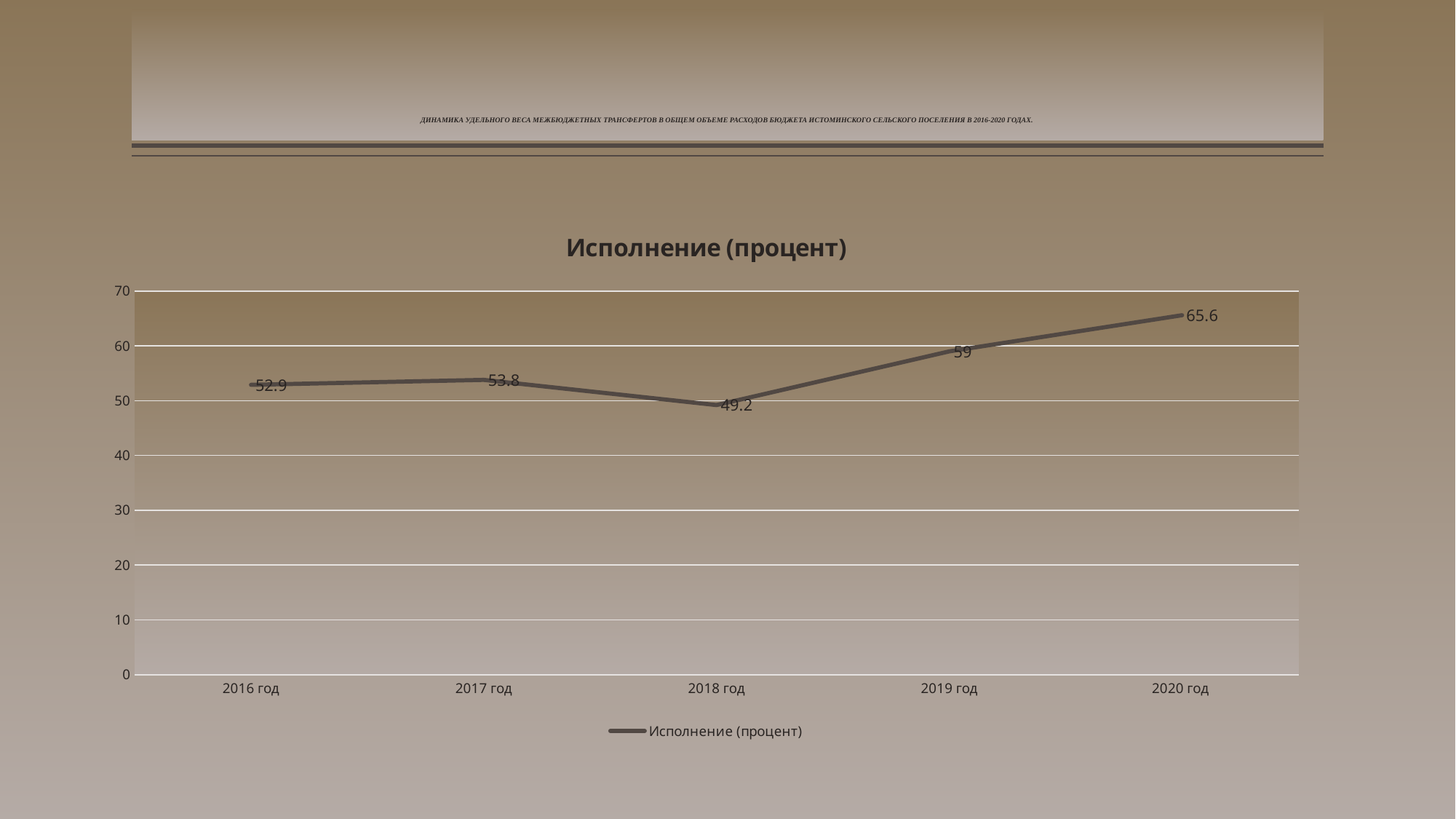
What kind of chart is shown? line chart What is the value for 2016 год? 52.9 Which year has the lowest value? 2018 год How many series does the legend list? 1 How many years are plotted on the x axis? 5 What is the value for 2020 год? 65.6 What is the title of the chart? Исполнение (процент) Which is larger, the value for 2017 год or the value for 2018 год? 2017 год What is the difference between the values for 2020 год and 2019 год? 6.6 Is the value for 2019 год greater or less than 50? greater Which year has the highest value? 2020 год What is the value for 2018 год? 49.2